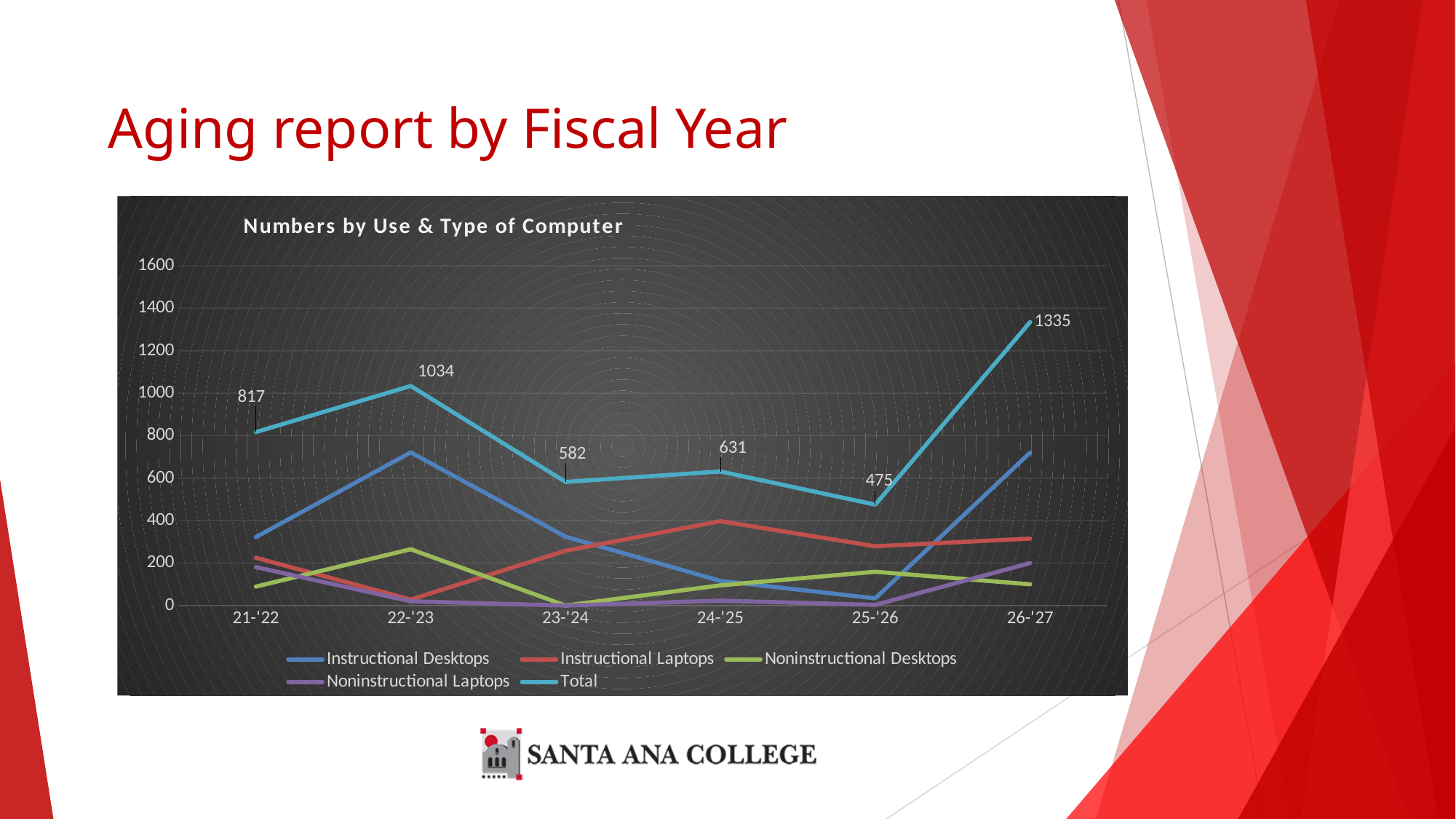
In which fiscal year is the Total highest? 26-'27 What is the Total value for 26-'27? 1335 What is the Total value for 21-'22? 817 What kind of chart is shown on the slide? Line chart In which fiscal year is the Total lowest? 25-'26 Which is larger, the Total for 24-'25 or the Total for 23-'24? 24-'25 How many series does the legend list? 5 Is the value for Instructional Desktops in 22-'23 greater or less than 600? greater How many fiscal years are shown on the x axis? 6 What is the difference between the Total for 22-'23 and the Total for 23-'24? 452 Is the value for Instructional Laptops in 24-'25 greater or less than 600? less What is the Total value for 25-'26? 475